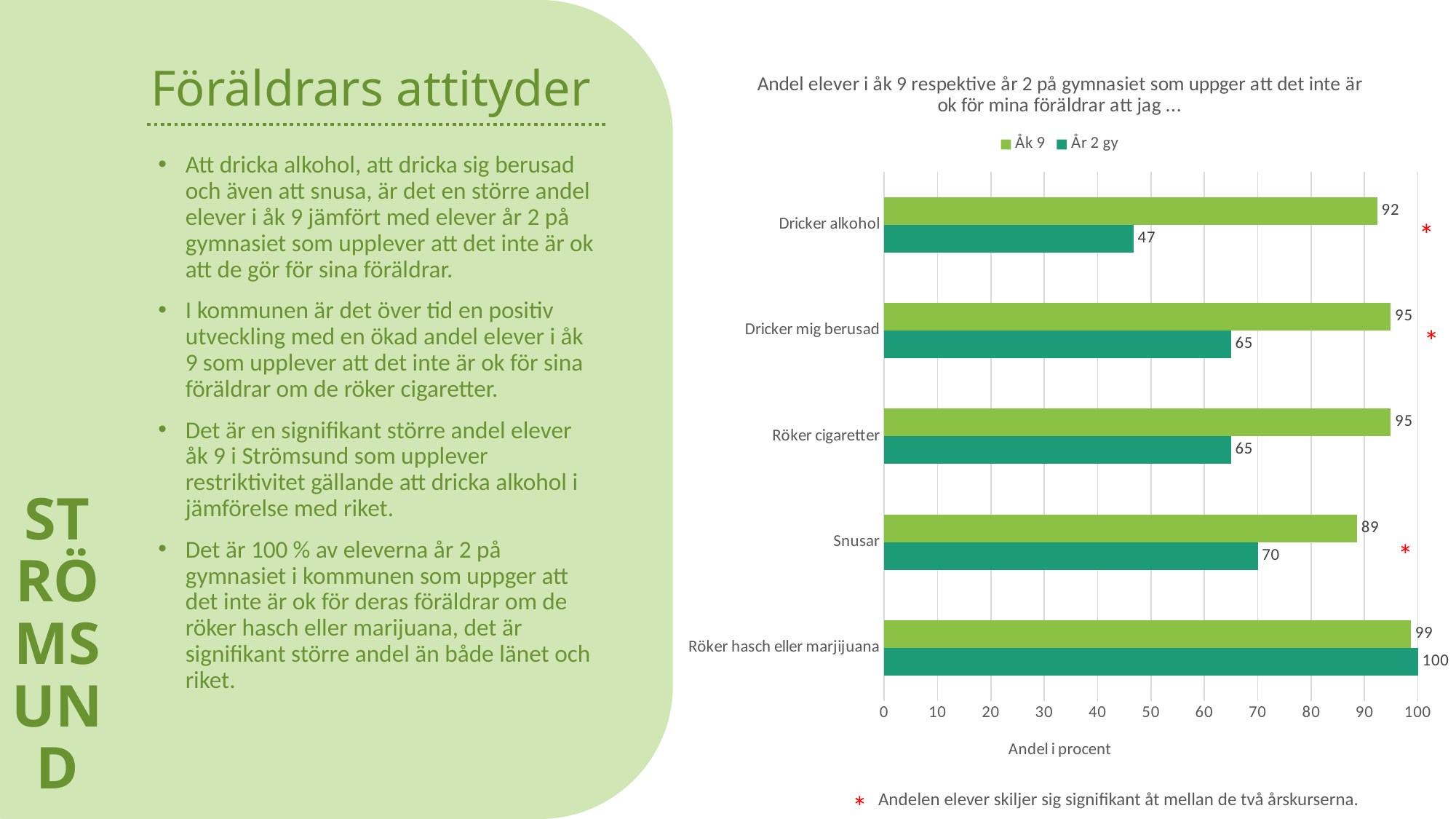
How many series does the chart legend list? 2 What is the label of the x axis? Andel i procent How many categories are shown on the chart? 5 Which category has the lowest År 2 gy value? Dricker alkohol What is the År 2 gy value for Snusar? 70 What is the År 2 gy value for Dricker alkohol? 47 What type of chart is shown on the slide? bar chart Which is larger for Snusar, the Åk 9 value or the År 2 gy value? Åk 9 What is the difference between the Åk 9 and År 2 gy values for Dricker mig berusad? 30 What is the Åk 9 value for Dricker alkohol? 92 What is the Åk 9 value for Röker hasch eller marjijuana? 99 Which category has the highest Åk 9 value? Röker hasch eller marjijuana